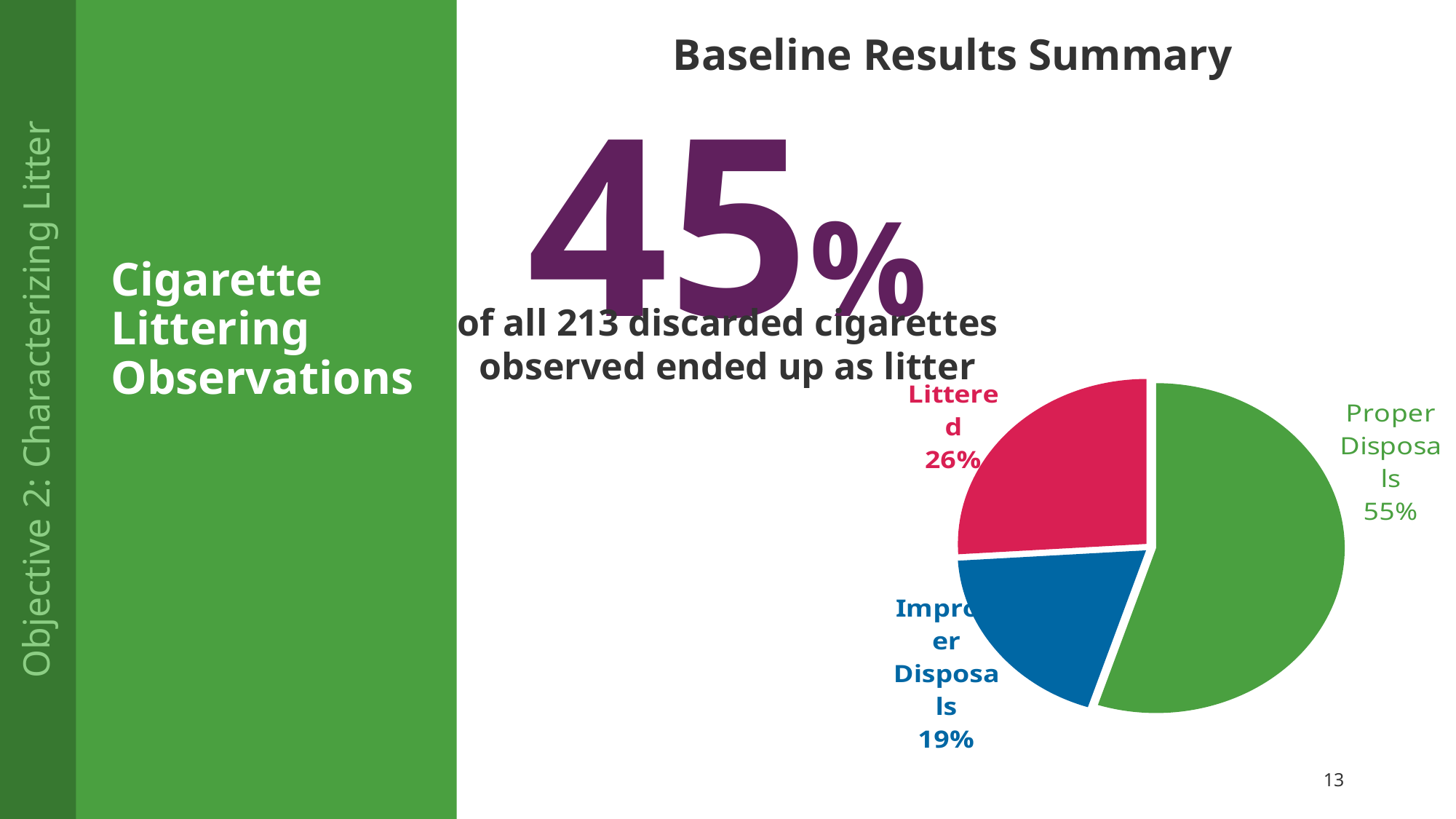
Which is larger, the Littered slice or the Improper Disposals slice? Littered What kind of chart is shown on the slide? pie chart What colour is the Littered slice of the pie chart? red What is the difference in percentage points between the Proper Disposals slice and the Littered slice? 29 What is the difference in percentage points between the Littered slice and the Improper Disposals slice? 7 Which slice of the pie chart is the smallest? Improper Disposals What colour is the Proper Disposals slice of the pie chart? green Which slice of the pie chart is the largest? Proper Disposals What share of the pie is labelled Proper Disposals? 55% What share of the pie is labelled Littered? 26% How many slices does the pie chart have? 3 What share of the pie is labelled Improper Disposals? 19%